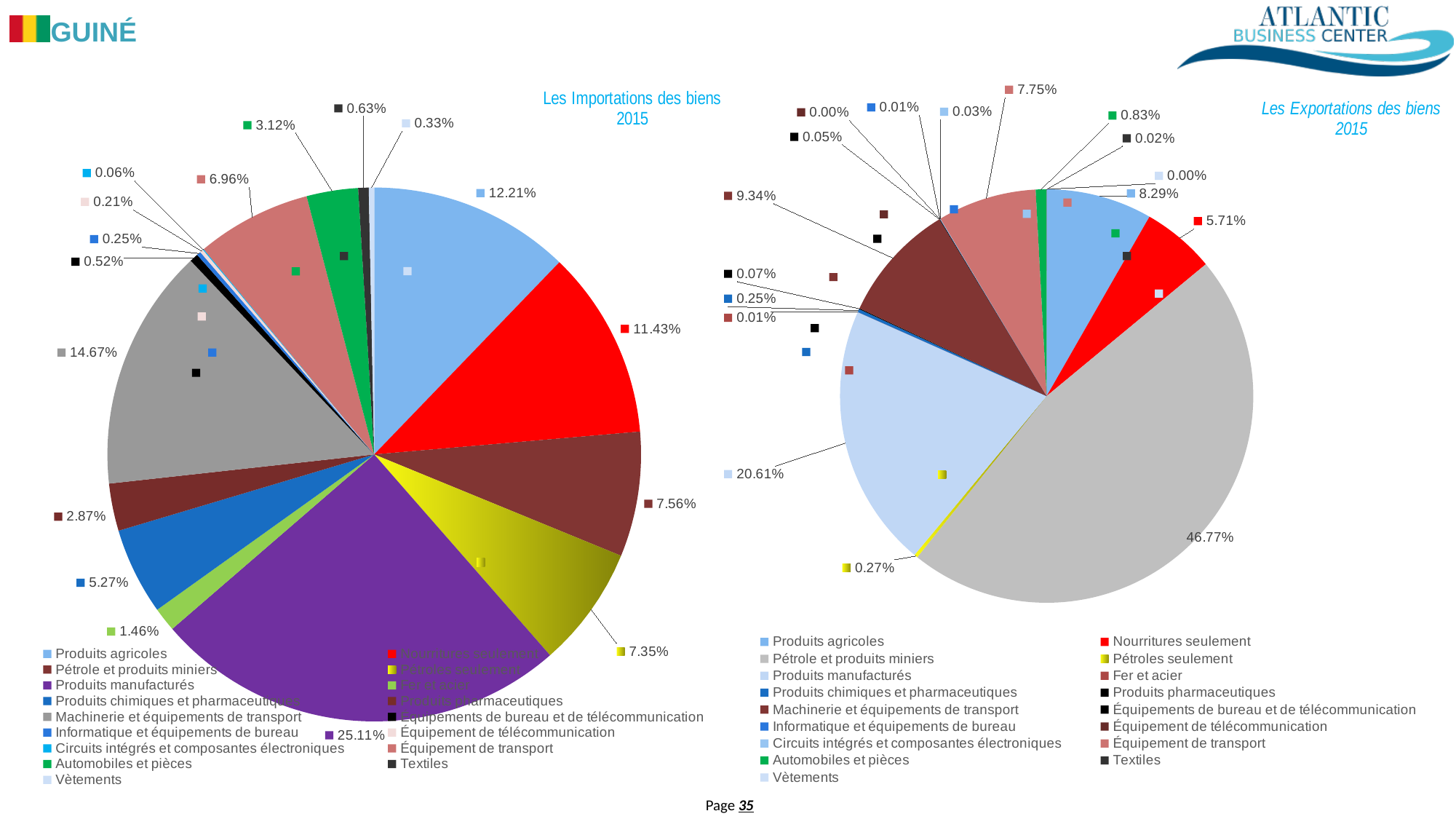
In the 'Les Importations des biens 2015' chart, what share is shown for Machinerie et équipements de transport? 14.67% In the 'Les Exportations des biens 2015' chart, what is the difference between the shares of Machinerie et équipements de transport and Produits agricoles? 1.05% In the 'Les Importations des biens 2015' chart, what share is shown for Produits manufacturés? 25.11% In the 'Les Importations des biens 2015' chart, what is the difference between the shares of Produits agricoles and Nourritures seulement? 0.78% In the 'Les Exportations des biens 2015' chart, what share is shown for Pétrole et produits miniers? 46.77% In the 'Les Exportations des biens 2015' chart, what share is shown for Produits manufacturés? 20.61% In the 'Les Importations des biens 2015' chart, which category has the largest slice? Produits manufacturés In the 'Les Exportations des biens 2015' chart, which category has the largest slice? Pétrole et produits miniers In the 'Les Exportations des biens 2015' chart, which is larger: Nourritures seulement or Équipement de transport? Équipement de transport In the 'Les Importations des biens 2015' chart, which is larger: Équipement de transport or Automobiles et pièces? Équipement de transport What type of chart is 'Les Importations des biens 2015'? Pie chart How many categories does the legend of the 'Les Exportations des biens 2015' chart list? 17